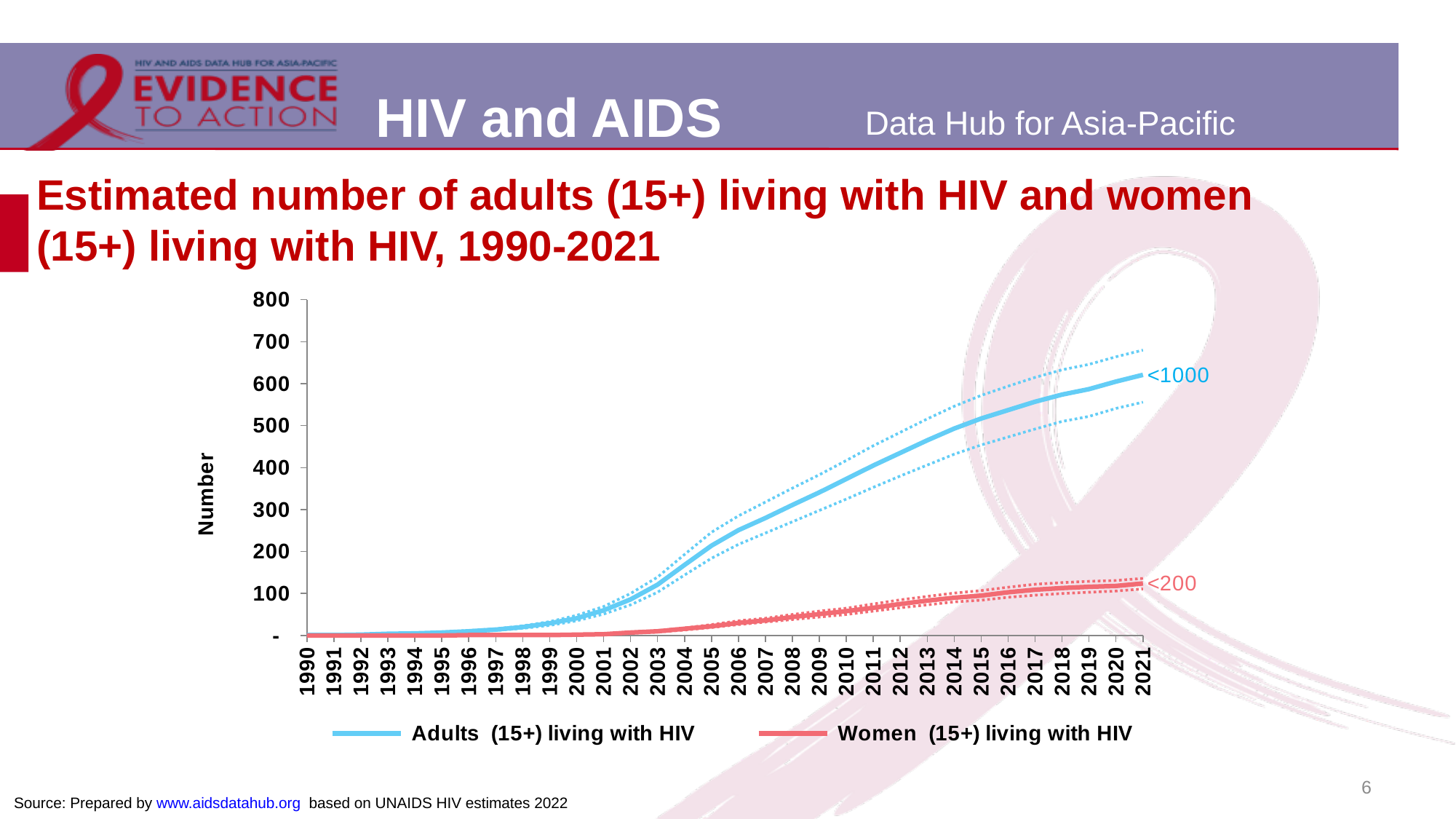
What is the title of the y axis? Number Which series is higher in 2021, Adults (15+) living with HIV or Women (15+) living with HIV? Adults (15+) living with HIV Does the Adults (15+) living with HIV line rise or fall from 1990 to 2021? rise What label is printed at the end of the Women (15+) living with HIV line in 2021? <200 What kind of chart is shown on the slide? line chart How many years are shown on the x axis? 32 Is the value for Women (15+) living with HIV in 2021 greater or less than 200? less Is the value for Adults (15+) living with HIV in 2000 greater or less than 100? less How many series does the legend list? 2 Is the value for Adults (15+) living with HIV in 2021 greater or less than 500? greater What colour is the line for Women (15+) living with HIV? red What label is printed at the end of the Adults (15+) living with HIV line in 2021? <1000